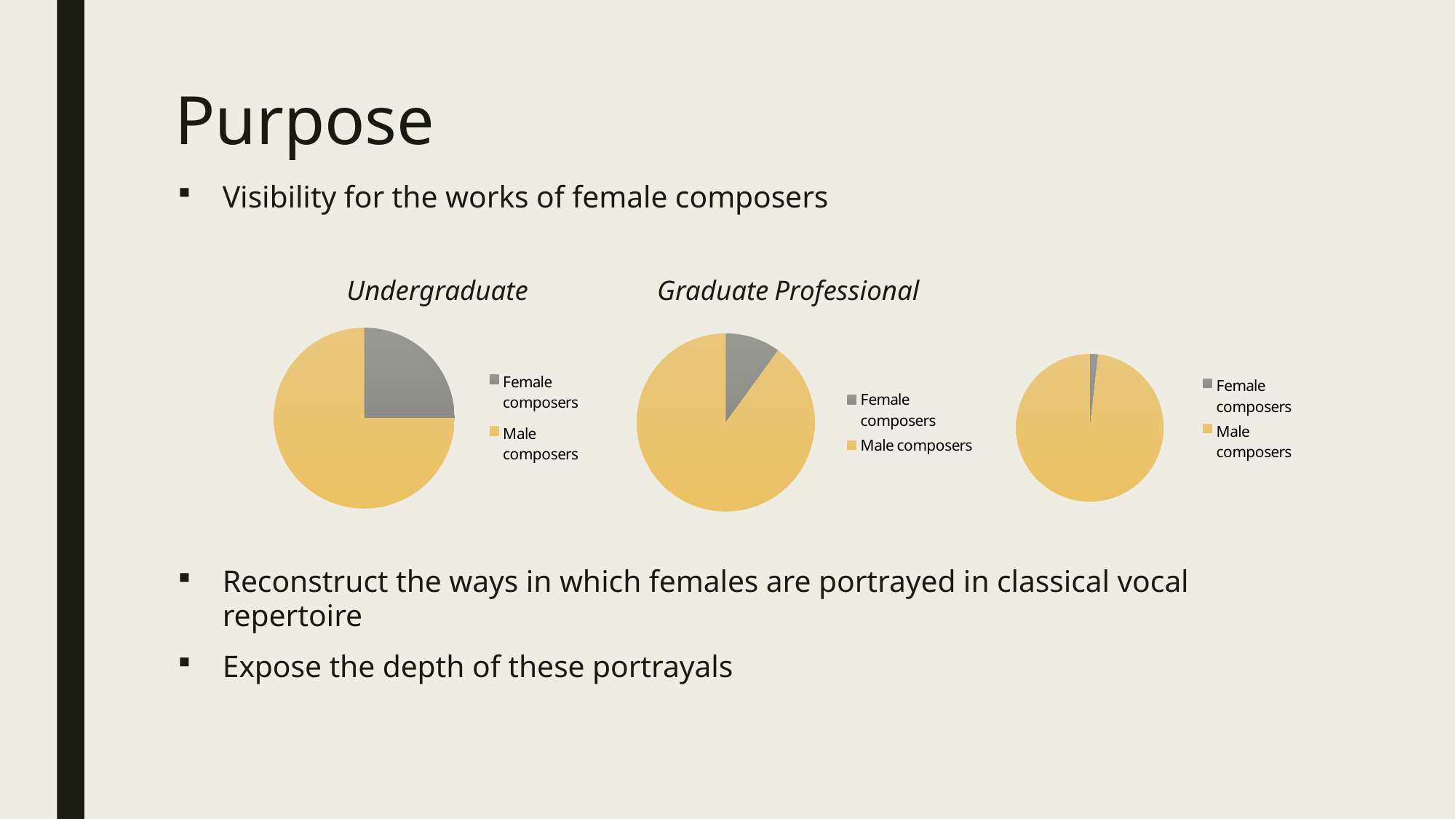
In the left chart (Undergraduate), which category has the smallest slice? Female composers In the left chart (Undergraduate), what colour represents Female composers? Grey How many pie charts are shown on the slide? 3 In the middle chart, what colour represents Male composers? Yellow In the right chart, which category has the smallest slice? Female composers In the right chart, which slice is larger: Female composers or Male composers? Male composers What kind of chart is the left chart, titled Undergraduate? Pie chart In the middle chart, which category has the largest slice? Male composers How many entries does the legend of the middle chart list? 2 In the left chart (Undergraduate), which slice is larger: Female composers or Male composers? Male composers What kind of chart is the middle chart on the slide? Pie chart How many entries does the legend of the left chart (Undergraduate) list? 2